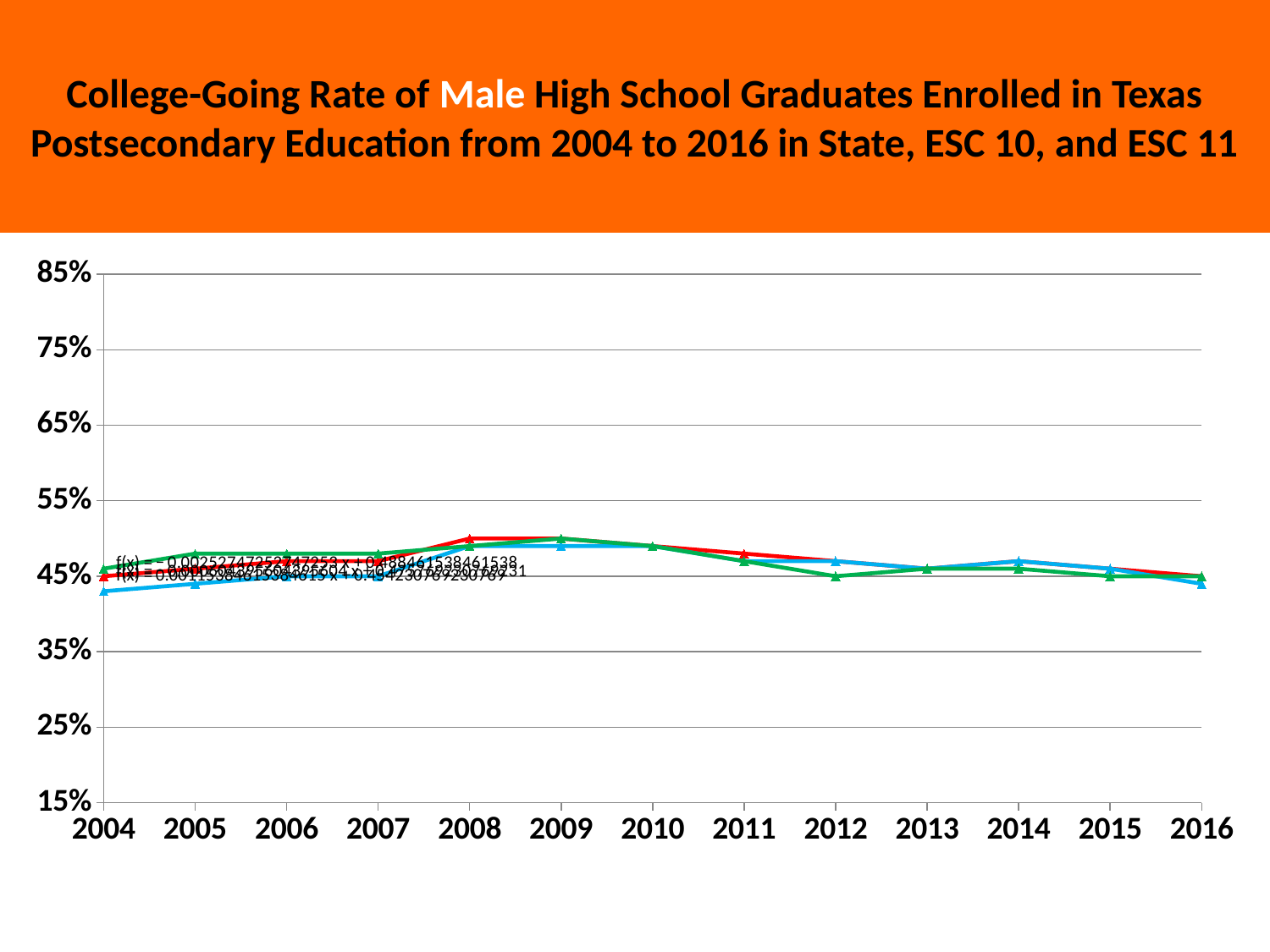
Is the value for 2009 greater or less than 55%? less Is the value for 2016 greater or less than 55%? less What is the last year shown on the x axis? 2016 What kind of chart is shown on the slide? line chart How many years are plotted along the x axis? 13 Is the value for 2004 greater or less than 35%? greater Do the values generally rise or fall from 2009 to 2016? fall What is the first year shown on the x axis? 2004 What is the highest value shown on the y axis? 85%